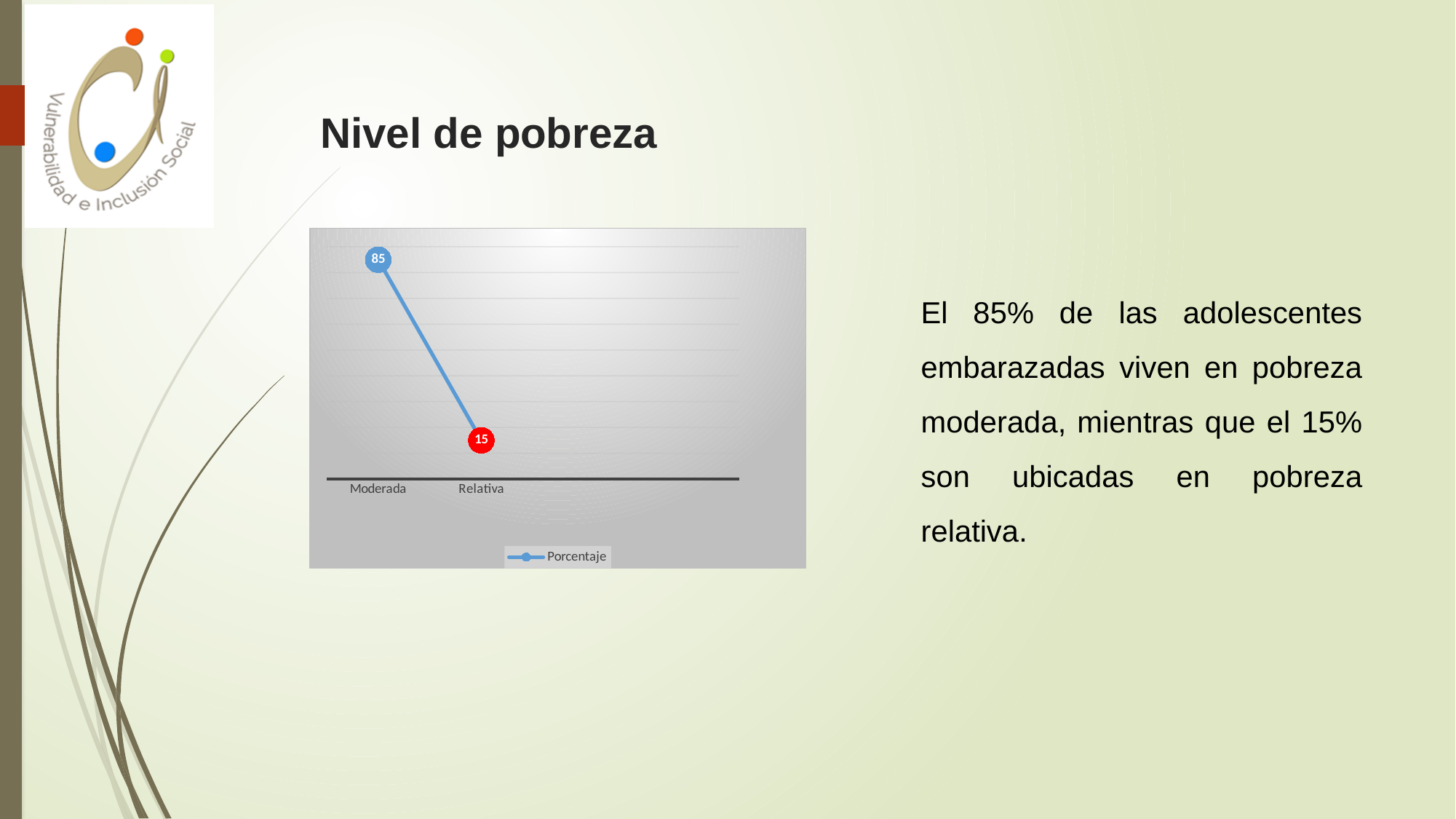
Which category has the lowest value? Relativa Do the values rise or fall from Moderada to Relativa? fall How many series does the legend list? 1 Which is larger, the value for Moderada or the value for Relativa? Moderada What is the value for Relativa? 15 What kind of chart is shown on the slide? line chart How many categories are plotted on the chart? 2 What is the title of the slide containing the chart? Nivel de pobreza What is the difference between the values for Moderada and Relativa? 70 What is the value for Moderada? 85 Which category has the highest value? Moderada What is the name of the series shown in the legend? Porcentaje